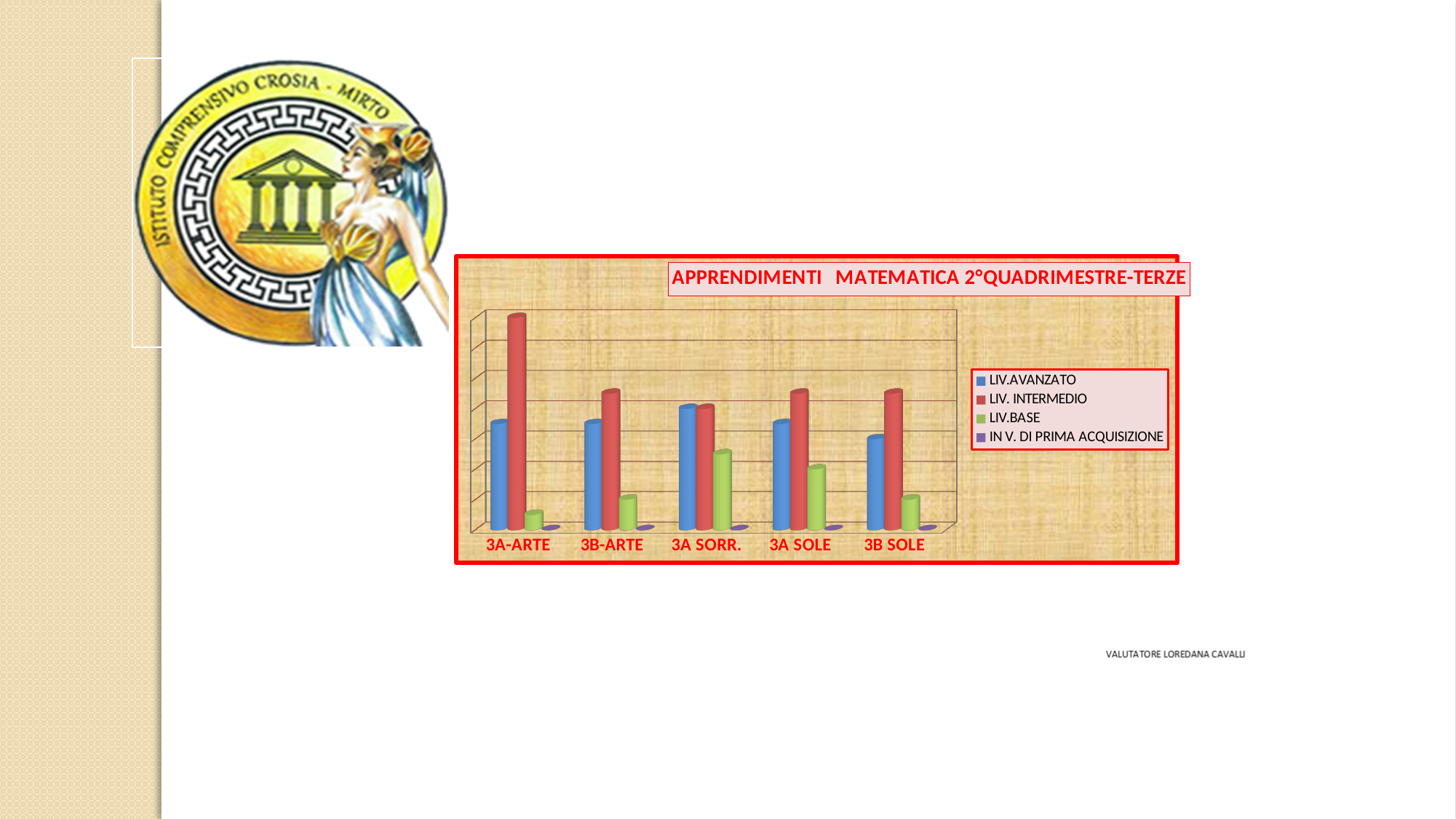
How many classes (categories) are shown on the x axis? 5 Which class has the highest LIV. INTERMEDIO bar? 3A-ARTE Which class has the highest LIV.AVANZATO bar? 3A SORR. Which series is shown in green in the legend? LIV.BASE Which class has the highest LIV.BASE bar? 3A SORR. Is the LIV. INTERMEDIO bar larger for 3A-ARTE or for 3B-ARTE? 3A-ARTE How many series does the legend list? 4 Is the LIV.BASE bar larger for 3A SORR. or for 3A SOLE? 3A SORR. What kind of chart is shown on the slide? bar chart Which class has the lowest LIV.BASE bar? 3A-ARTE What is the title of the chart? APPRENDIMENTI MATEMATICA 2°QUADRIMESTRE-TERZE